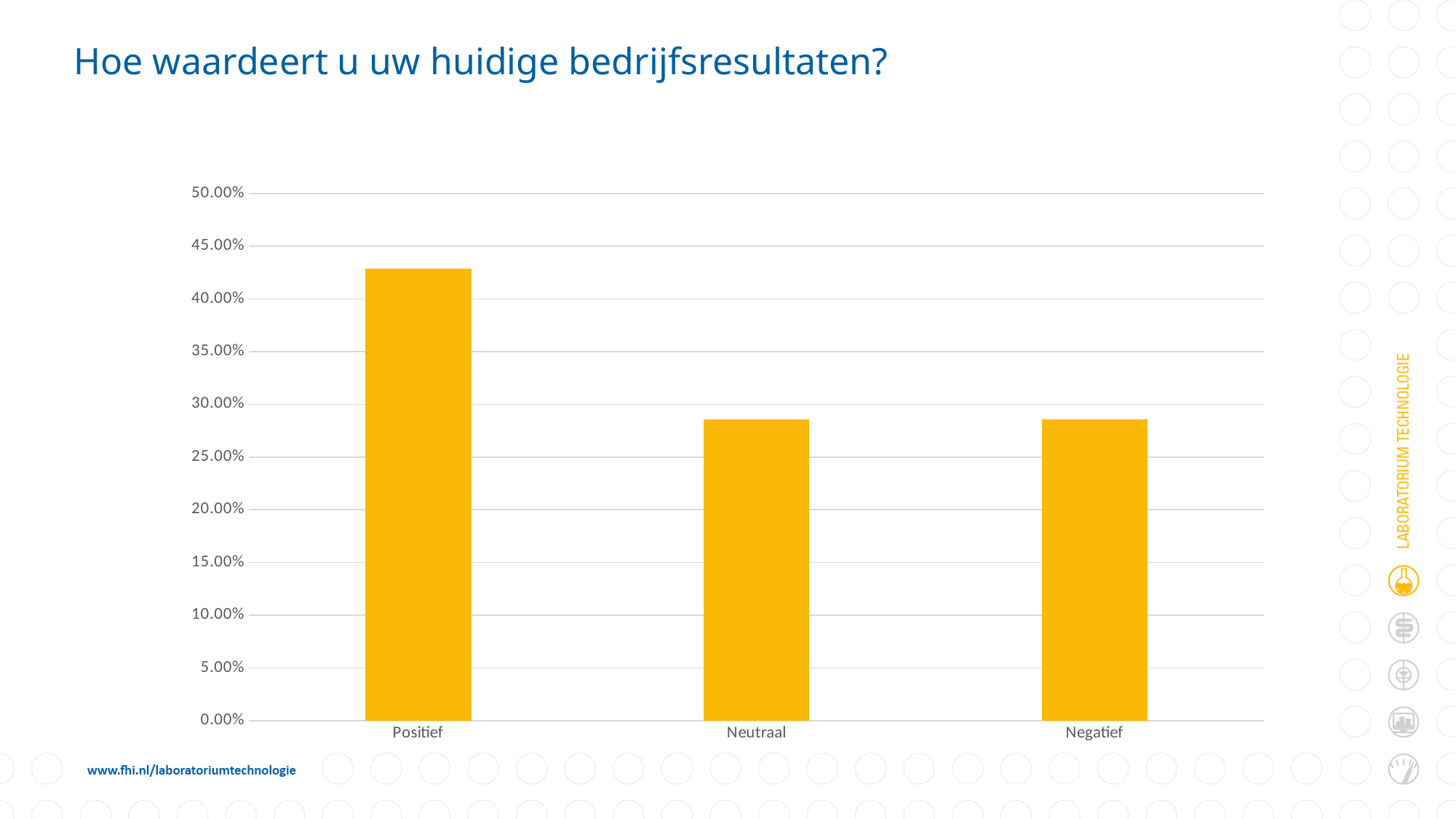
Which is larger, the value for Positief or the value for Neutraal? Positief Is the value for Negatief greater or less than 30.00%? less Is the value for Positief greater or less than 45.00%? less What colour are the bars in the chart? yellow/orange How many categories are shown on the x axis of the chart? 3 What is the title of the slide's chart? Hoe waardeert u uw huidige bedrijfsresultaten? Is the value for Neutraal greater or less than 30.00%? less Which category has the highest value in the chart? Positief Which is larger, the value for Positief or the value for Negatief? Positief What kind of chart is shown on the slide? bar chart